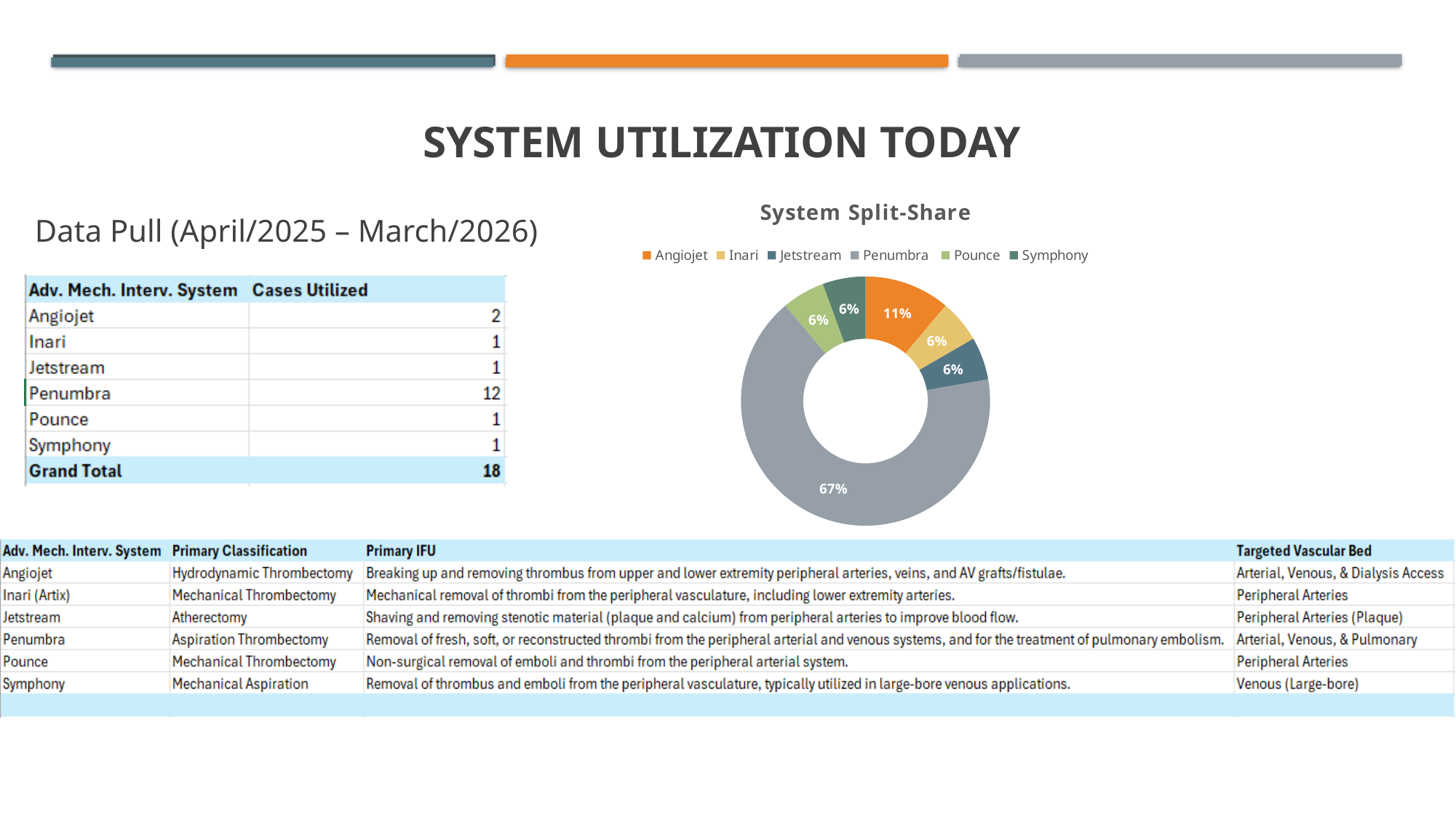
In the System Split-Share chart, what share does Inari have? 6% In the System Split-Share chart, which has the larger share, Angiojet or Jetstream? Angiojet What kind of chart is the System Split-Share chart? Doughnut chart What is the title of the chart on the slide? System Split-Share In the System Split-Share chart, what share does Penumbra have? 67% In the System Split-Share chart, what is the difference in percentage points between Penumbra and Angiojet? 56 percentage points In the System Split-Share chart, what colour is the Penumbra slice? Grey In the System Split-Share chart, what share does Symphony have? 6% Which system has the largest slice in the System Split-Share chart? Penumbra In the System Split-Share chart, what share does Angiojet have? 11% In the System Split-Share chart, is the share for Penumbra greater or less than 50%? greater How many systems are listed in the legend of the System Split-Share chart? 6